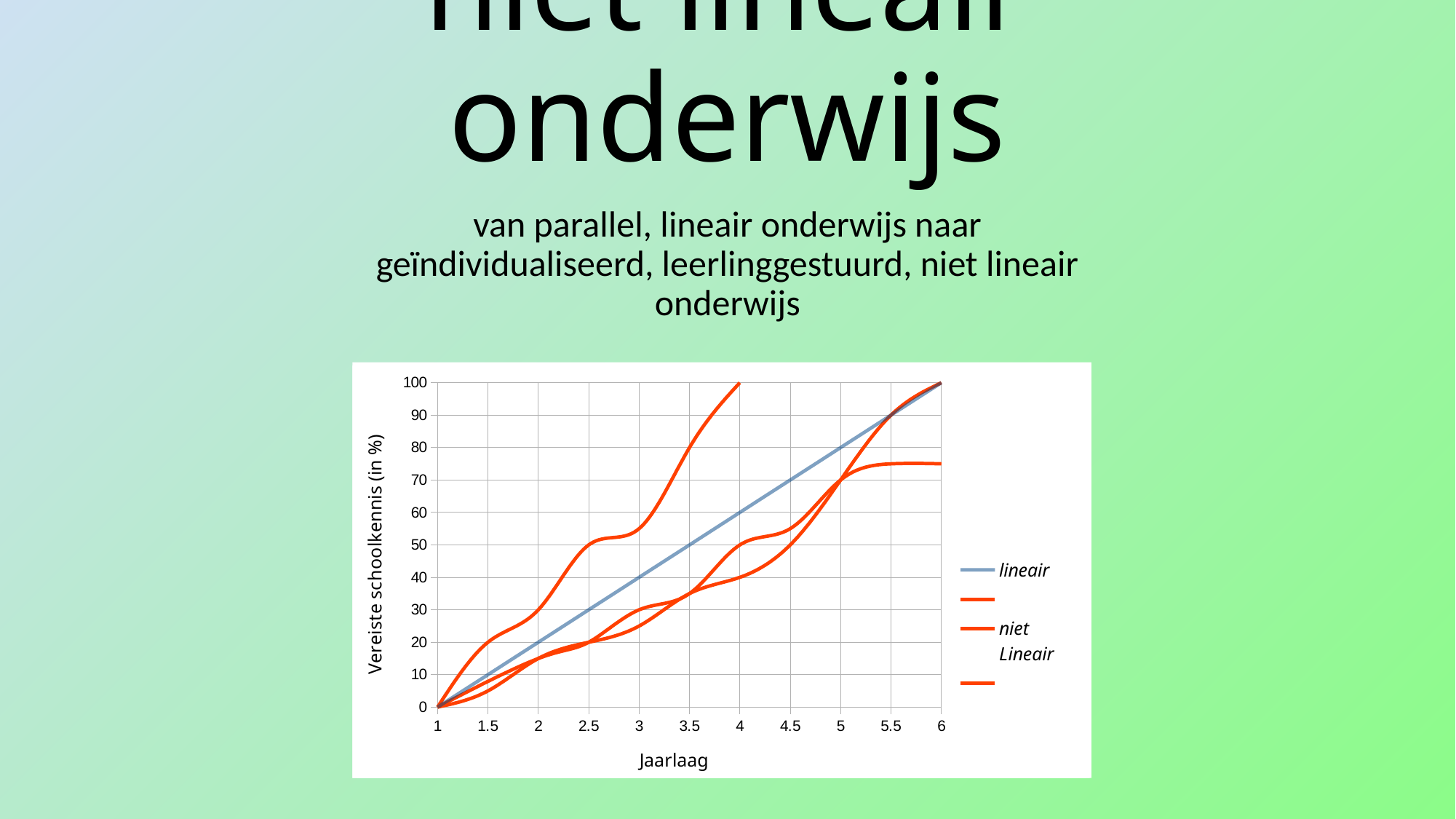
What is the highest value shown on the y axis of the chart? 100 Is the value at Jaarlaag 6 of the orange line that flattens out at the end greater or less than 70? greater What is the title of the y axis of the chart? Vereiste schoolkennis (in %) What is the value of the 'lineair' series at Jaarlaag 6? 100 What is the title of the x axis of the chart? Jaarlaag How many tick labels are shown on the x axis of the chart? 11 Does the 'lineair' series rise or fall as Jaarlaag increases from 1 to 6? rises Is the value at Jaarlaag 6 of the orange line that flattens out at the end greater or less than 80? less What is the value of the 'lineair' series at Jaarlaag 3.5? 50 What is the value of the 'lineair' series at Jaarlaag 1? 0 What kind of chart is shown on the slide? line chart How many series does the chart legend list? 4